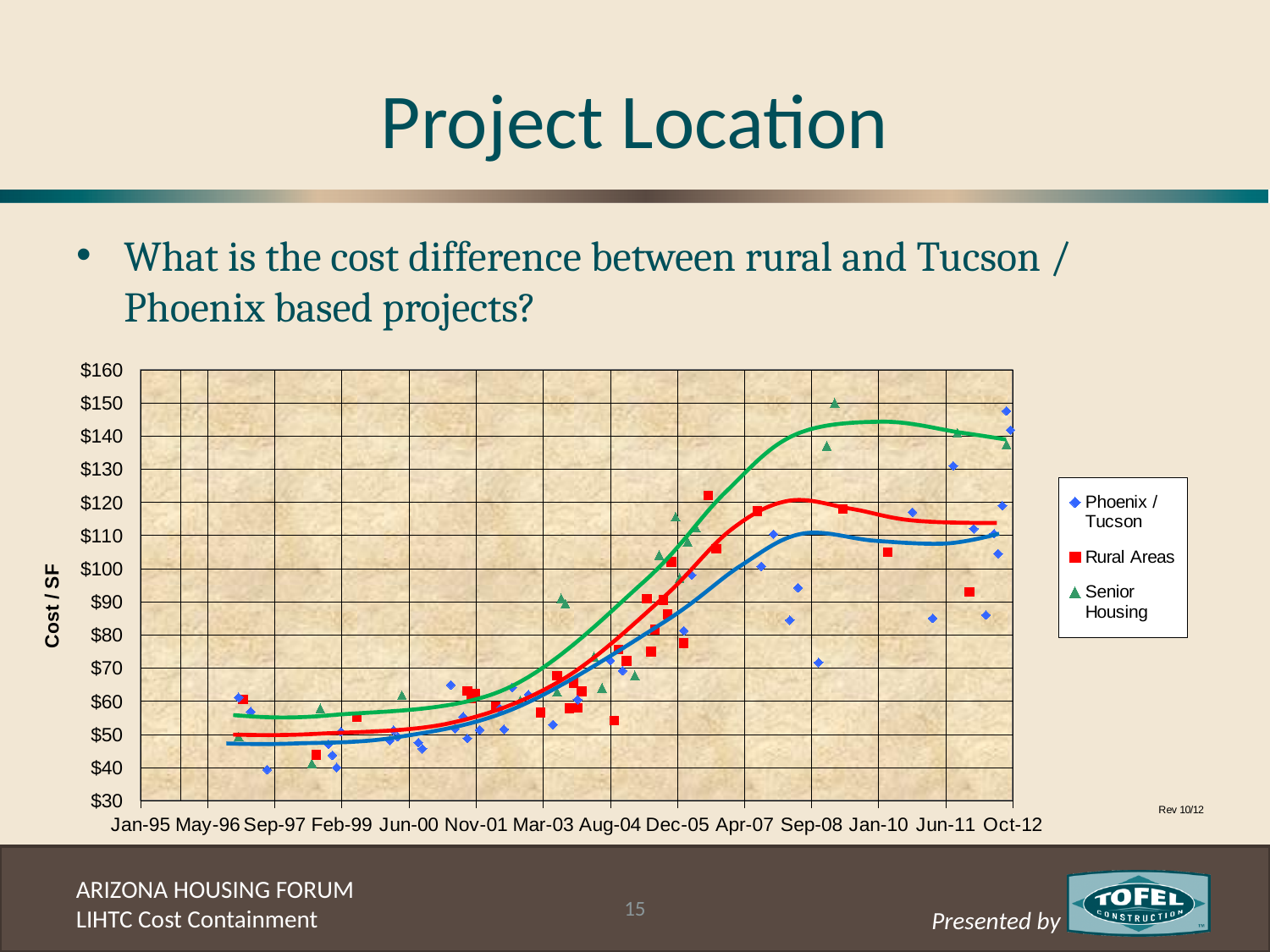
Is the highest Senior Housing data point on the chart greater or less than $140? greater What are the three series named in the chart legend? Phoenix / Tucson, Rural Areas, Senior Housing Is the lowest Phoenix / Tucson data point on the chart greater or less than $50? less What is the title of the vertical axis of the chart? Cost / SF How many date labels are shown along the x axis of the chart? 14 Which series has the lowest trend line at the right end of the chart (around Oct-12)? Phoenix / Tucson Which series has the highest trend line at the right end of the chart (around Oct-12)? Senior Housing What kind of chart is shown on the slide? scatter chart What is the maximum value shown on the vertical axis of the chart? $160 Around Sep-08, is the Senior Housing trend line higher or lower than the Rural Areas trend line? higher How many series does the chart legend list? 3 Do the cost values generally rise or fall from Jan-95 to Oct-12? rise